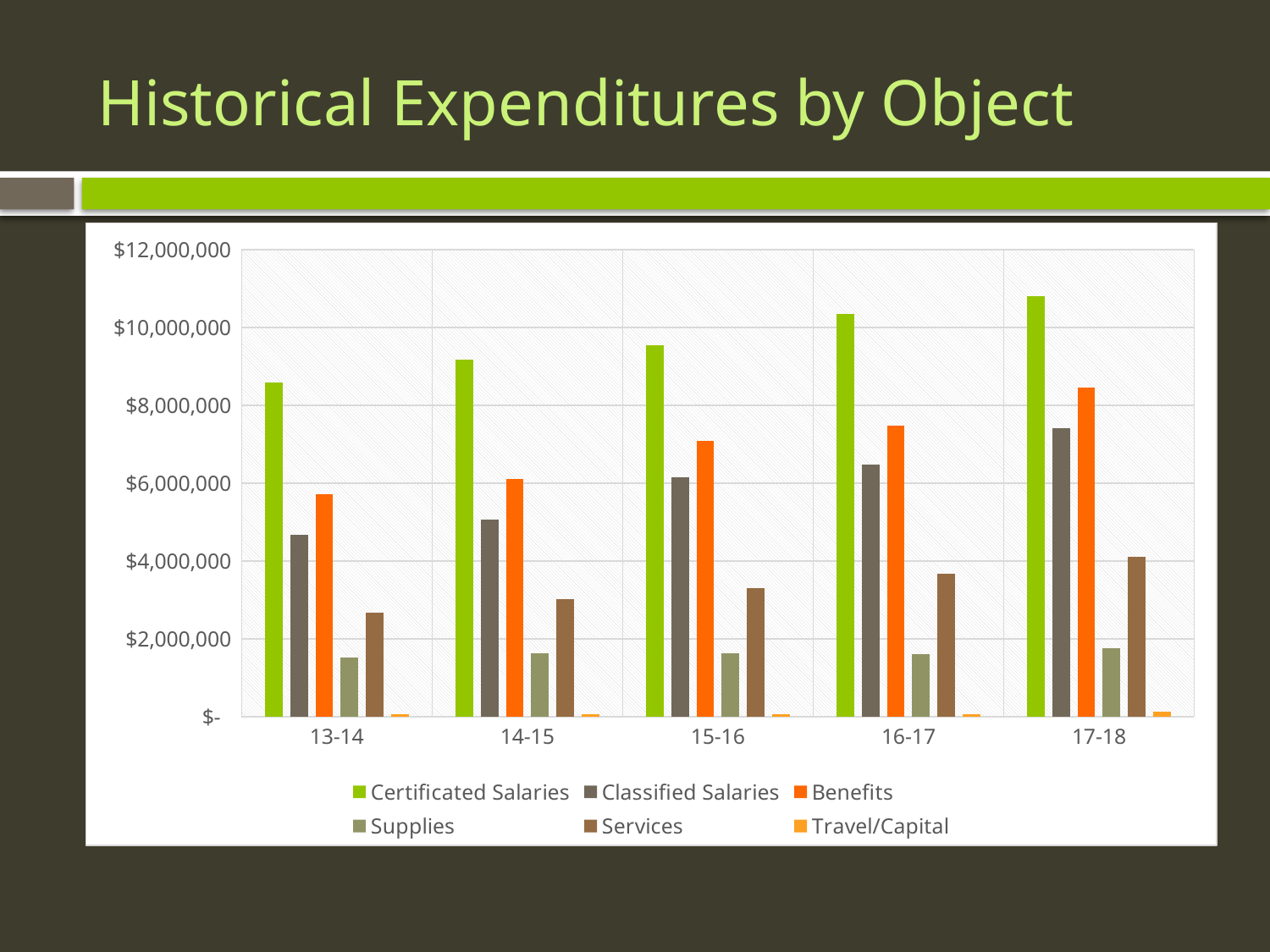
Is the value for Benefits in 13-14 greater or less than $6,000,000? less What is the title of the slide containing the chart? Historical Expenditures by Object In which year are Certificated Salaries highest? 17-18 In 15-16, which is larger: Classified Salaries or Benefits? Benefits In which year are Benefits lowest? 13-14 What kind of chart is shown on the slide? bar chart Which series is shown in orange in the legend? Benefits How many fiscal years are shown on the x axis? 5 Is the value for Classified Salaries in 17-18 greater or less than $6,000,000? greater Do Certificated Salaries rise or fall from 13-14 to 17-18? rise Is the value for Certificated Salaries in 16-17 greater or less than $10,000,000? greater How many series does the legend list? 6